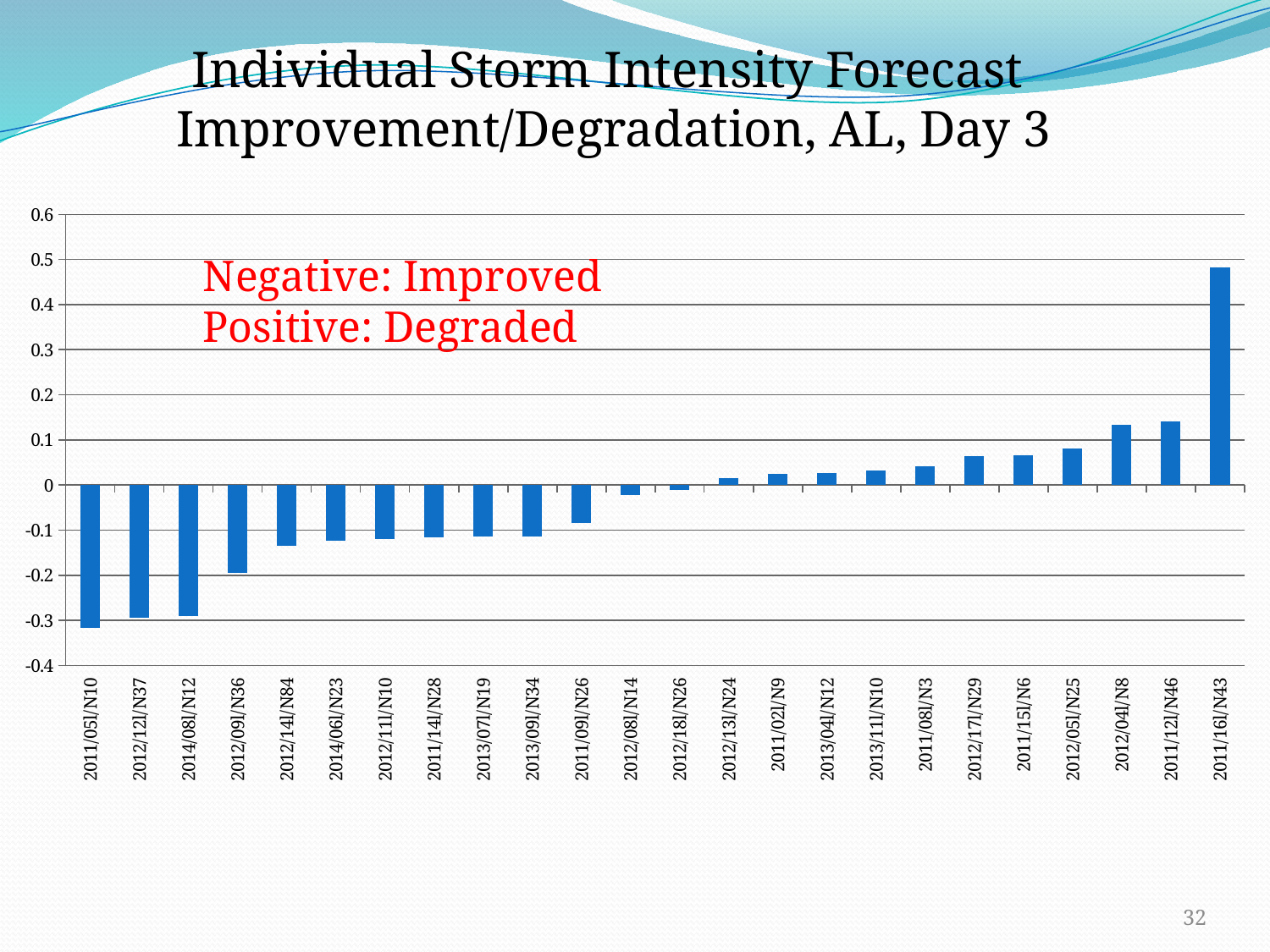
Is the value for 2014/08I/N12 greater or less than -0.2? less Is the value for 2011/12I/N46 greater or less than 0.1? greater Which storm has the highest value on the chart? 2011/16I/N43 According to the annotation on the chart, what does a negative value indicate? Improved Is the value for 2012/09I/N36 greater or less than -0.1? less What kind of chart is shown on the slide? bar chart Which has the larger value, 2011/16I/N43 or 2011/12I/N46? 2011/16I/N43 How many storm categories are plotted along the x axis? 24 Which storm has the lowest value on the chart? 2011/05I/N10 Do the values generally rise or fall moving from left to right along the x axis? rise